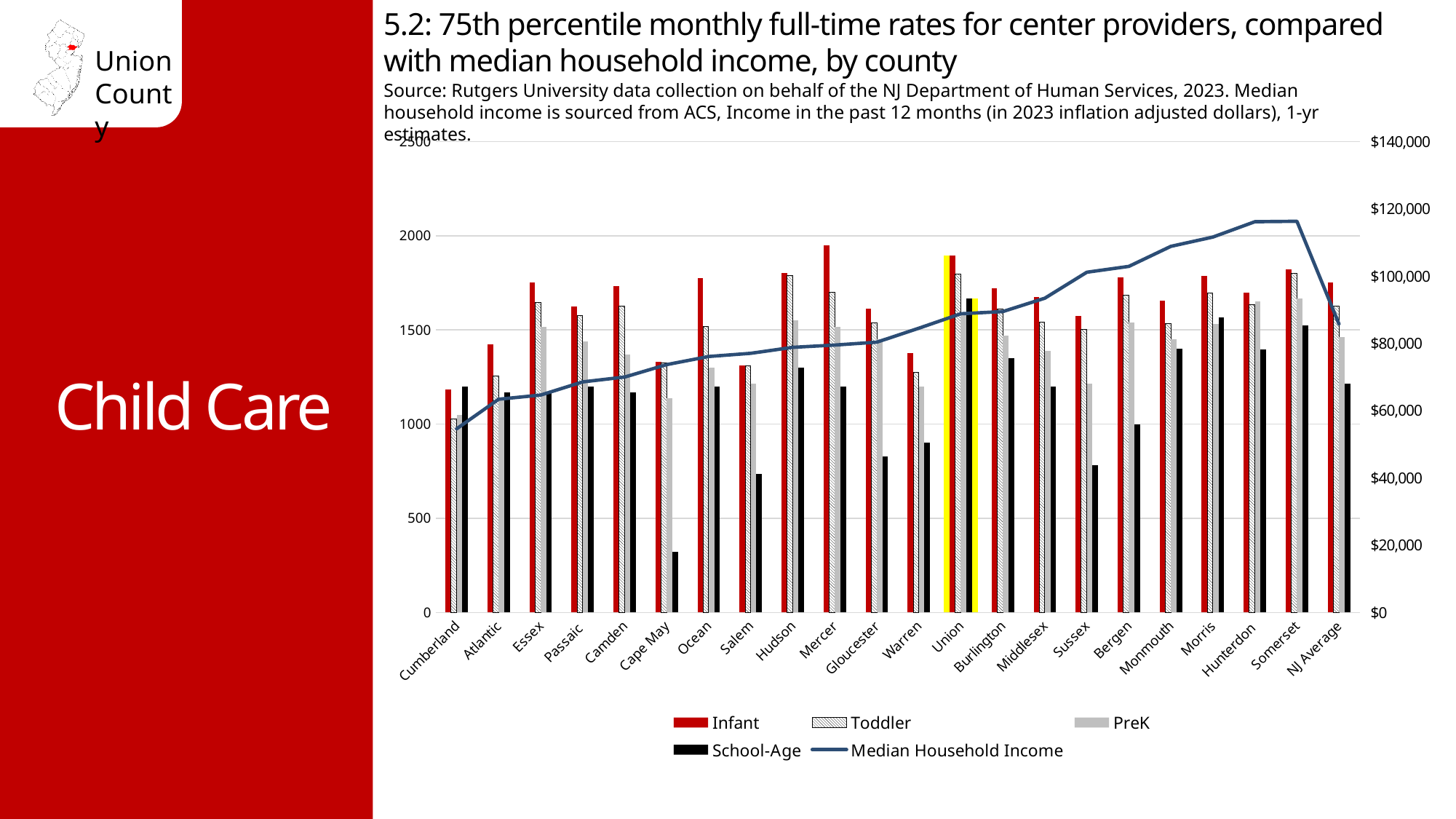
What kind of chart is shown on the slide? Combined bar and line chart Which county has the lowest Infant rate? Cumberland How many series does the legend list? 5 Is the Median Household Income for Somerset greater or less than $100,000? greater Does the Median Household Income line generally rise or fall from Cumberland to Somerset? rise How many counties/categories are shown along the x axis? 22 Is the School-Age rate for Cape May greater or less than 500? less Which county has the highest Infant rate? Mercer Which county has the lowest School-Age rate? Cape May Which county has the higher Infant rate, Essex or Atlantic? Essex Which county's bars are highlighted in yellow? Union Is the Infant rate for Cumberland greater or less than 1000? greater